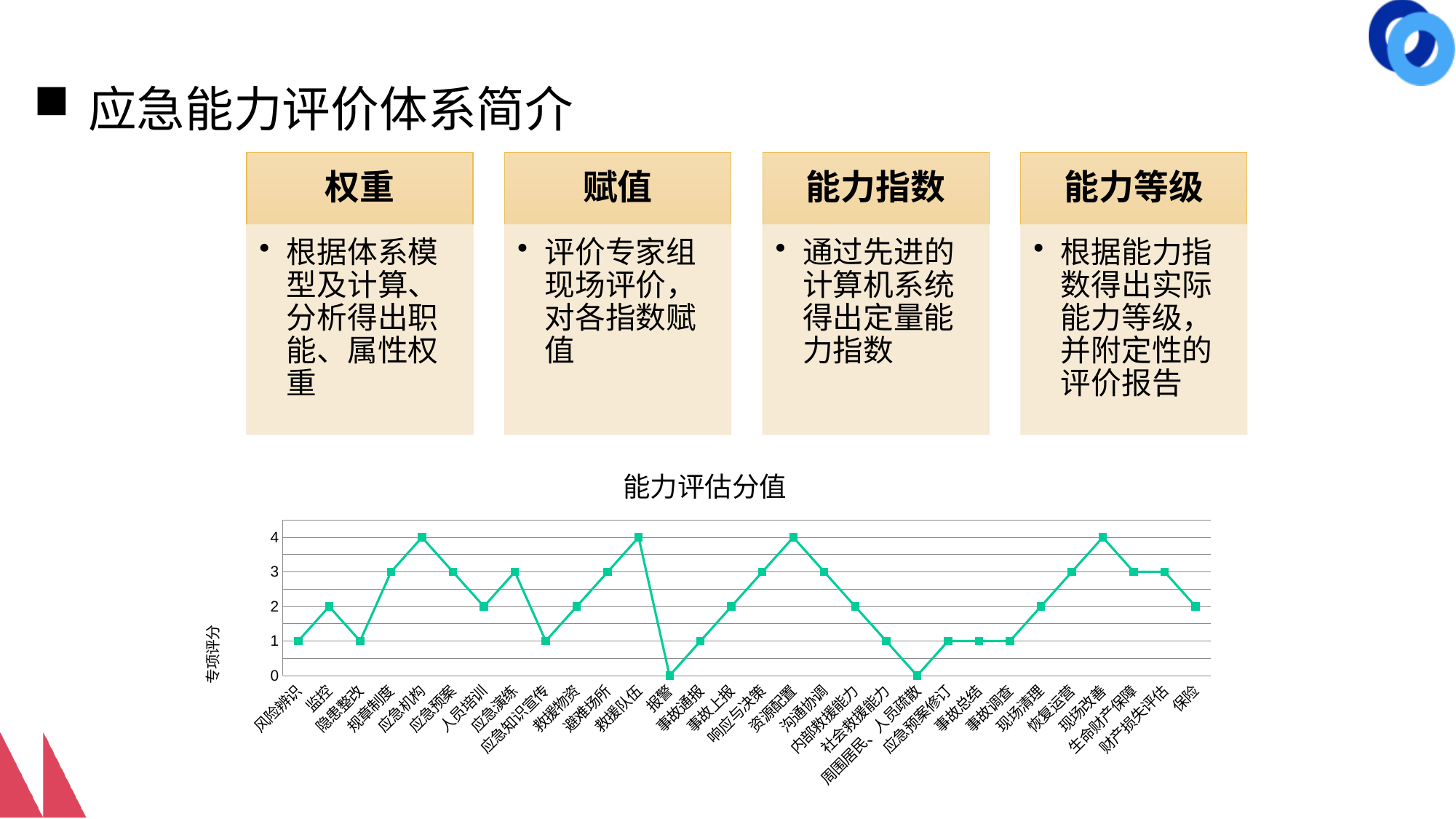
Which is larger, the value for 资源配置 or the value for 沟通协调? 资源配置 What is the value for 风险辨识? 1 What type of chart is shown on the slide? line chart What is the difference between the value for 救援队伍 and the value for 报警? 4 What is the title of the chart? 能力评估分值 What is the y-axis label of the chart? 专项评分 Is the value for 现场改善 greater or less than 2? greater What is the value for 应急机构? 4 What is the value for 保险? 2 What is the value for 恢复运营? 3 What is the value for 报警? 0 How many categories are plotted on the x axis? 30